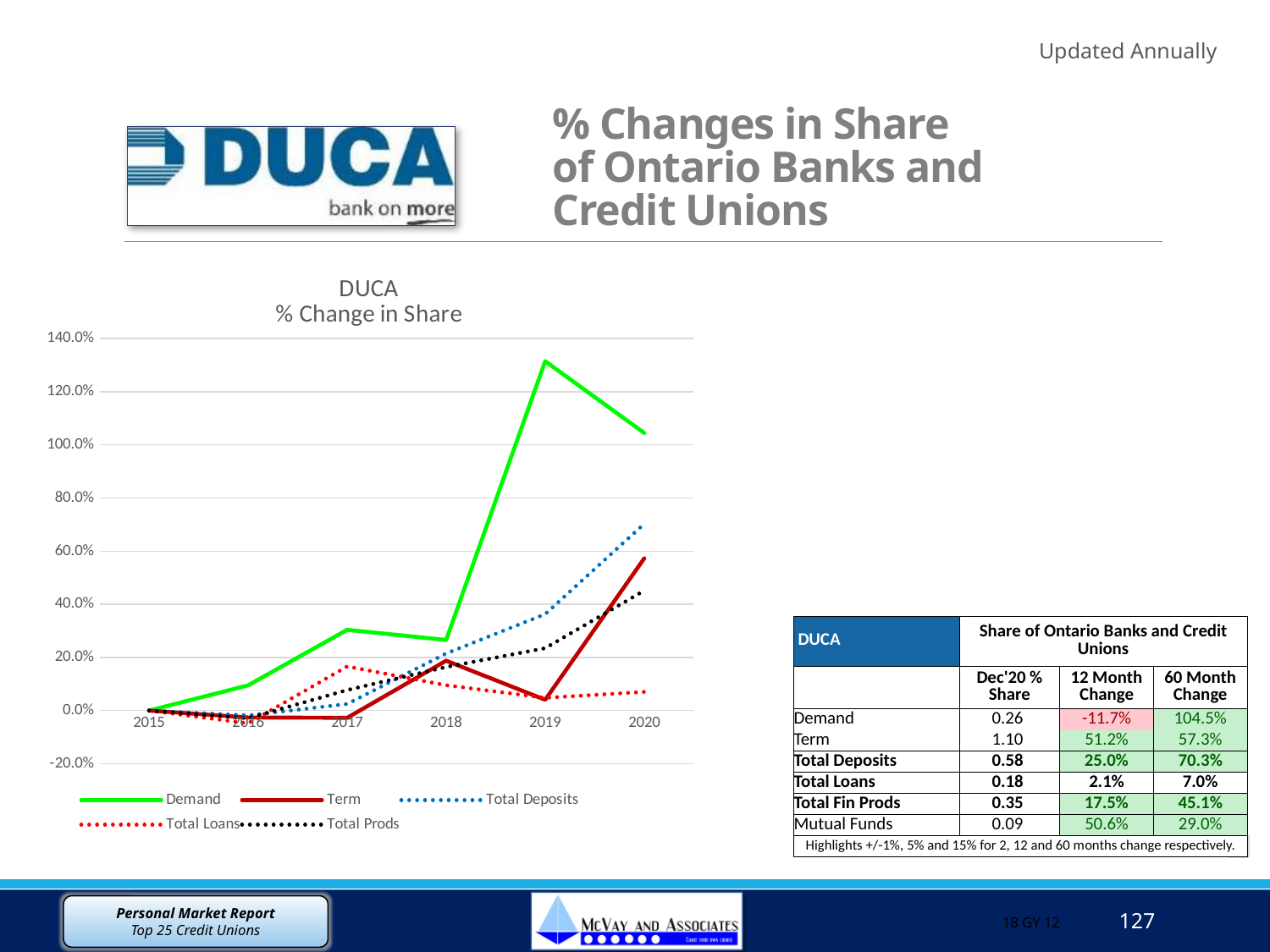
What is the title of the chart? DUCA % Change in Share Is the value for Total Loans in 2020 greater or less than 20.0%? less What kind of chart is shown on the slide? line chart Is the value for Demand in 2020 greater or less than 100.0%? greater Which is larger in 2020, the value for Demand or the value for Term? Demand Which series has the highest value in 2019? Demand Does the Demand series rise or fall from 2015 to 2019? rise Is the value for Term in 2020 greater or less than 40.0%? greater Which is larger in 2020, the value for Total Deposits or the value for Total Loans? Total Deposits How many series does the legend of the chart list? 5 How many years are plotted along the x axis of the chart? 6